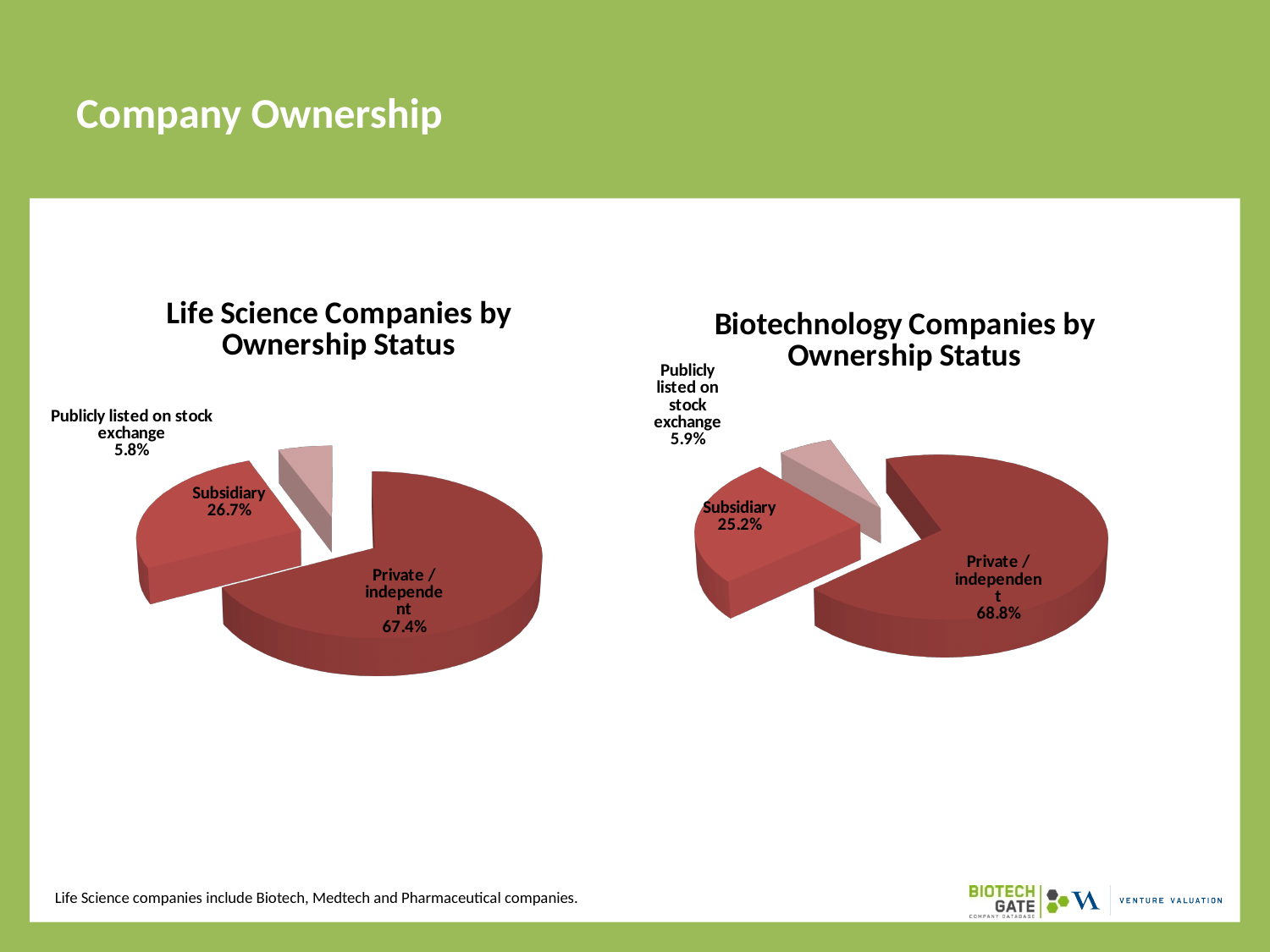
In the 'Life Science Companies by Ownership Status' chart, what share is Private / independent? 67.4% What kind of chart is the 'Life Science Companies by Ownership Status' chart? Pie chart In the 'Life Science Companies by Ownership Status' chart, what is the difference between the Subsidiary share and the Publicly listed on stock exchange share? 20.9% In the 'Life Science Companies by Ownership Status' chart, which category has the largest share? Private / independent How many charts are on the slide? 2 Which is larger: the Subsidiary share in the 'Life Science Companies by Ownership Status' chart or the Subsidiary share in the 'Biotechnology Companies by Ownership Status' chart? Life Science Companies by Ownership Status In the 'Biotechnology Companies by Ownership Status' chart, which category has the smallest share? Publicly listed on stock exchange What is the title of the chart on the right side of the slide? Biotechnology Companies by Ownership Status In the 'Life Science Companies by Ownership Status' chart, what share is Subsidiary? 26.7% In the 'Biotechnology Companies by Ownership Status' chart, what share is Subsidiary? 25.2% How many categories does the 'Biotechnology Companies by Ownership Status' chart show? 3 In the 'Biotechnology Companies by Ownership Status' chart, what share is Publicly listed on stock exchange? 5.9%